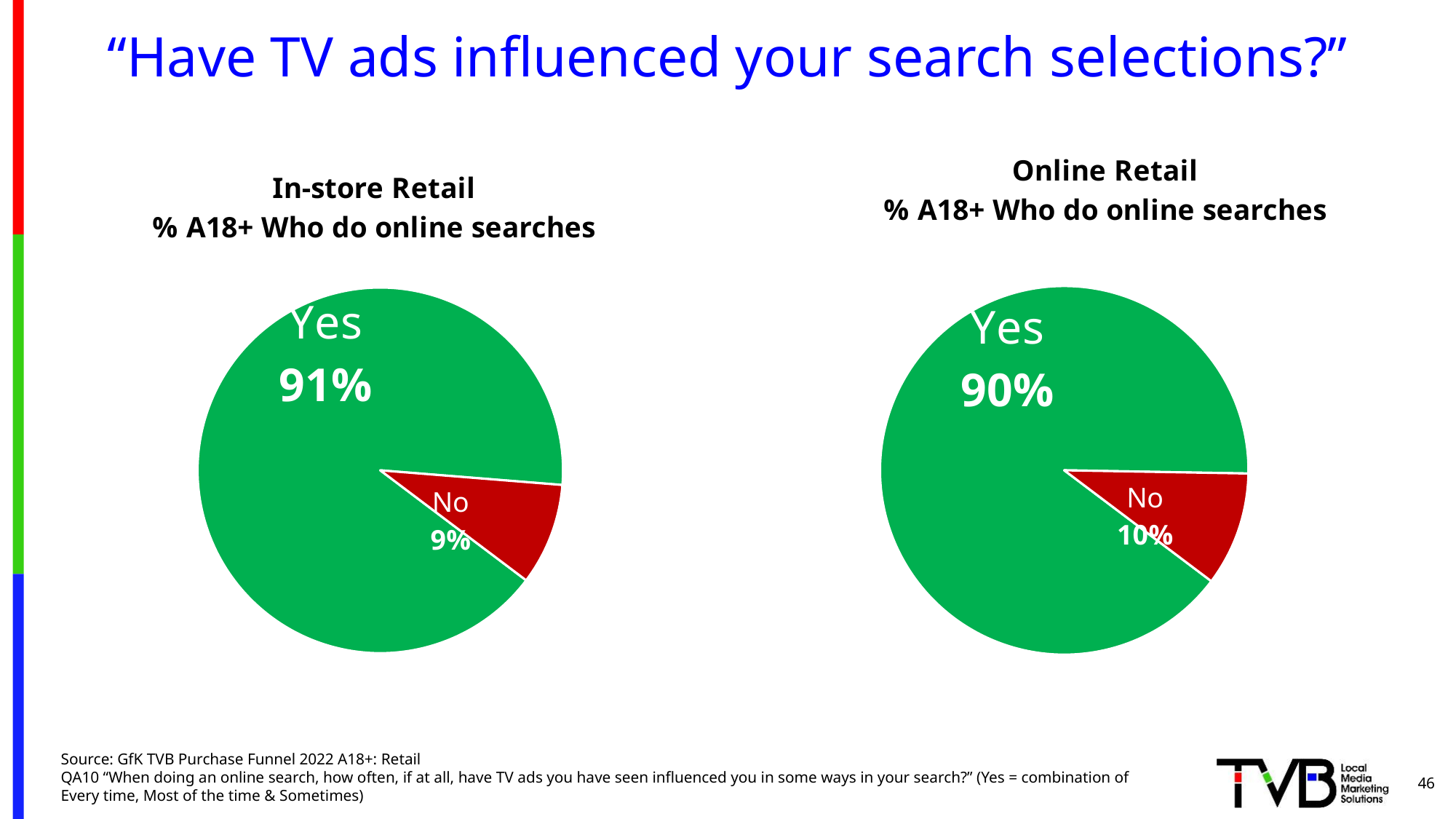
In the In-store Retail chart, which response has the largest slice? Yes In the In-store Retail chart, what is the difference between the Yes and No percentages? 82% In the In-store Retail chart, what percentage answered No? 9% What kind of chart is the In-store Retail chart? Pie chart What is the subtitle shown under the In-store Retail chart title? % A18+ Who do online searches In the In-store Retail chart, what percentage answered Yes? 91% In the Online Retail chart, what colour is the No slice? Red In the Online Retail chart, what percentage answered Yes? 90% In the Online Retail chart, which response has the smallest slice? No How many slices does the Online Retail pie chart have? 2 Which chart has the larger Yes percentage, In-store Retail or Online Retail? In-store Retail In the Online Retail chart, what percentage answered No? 10%